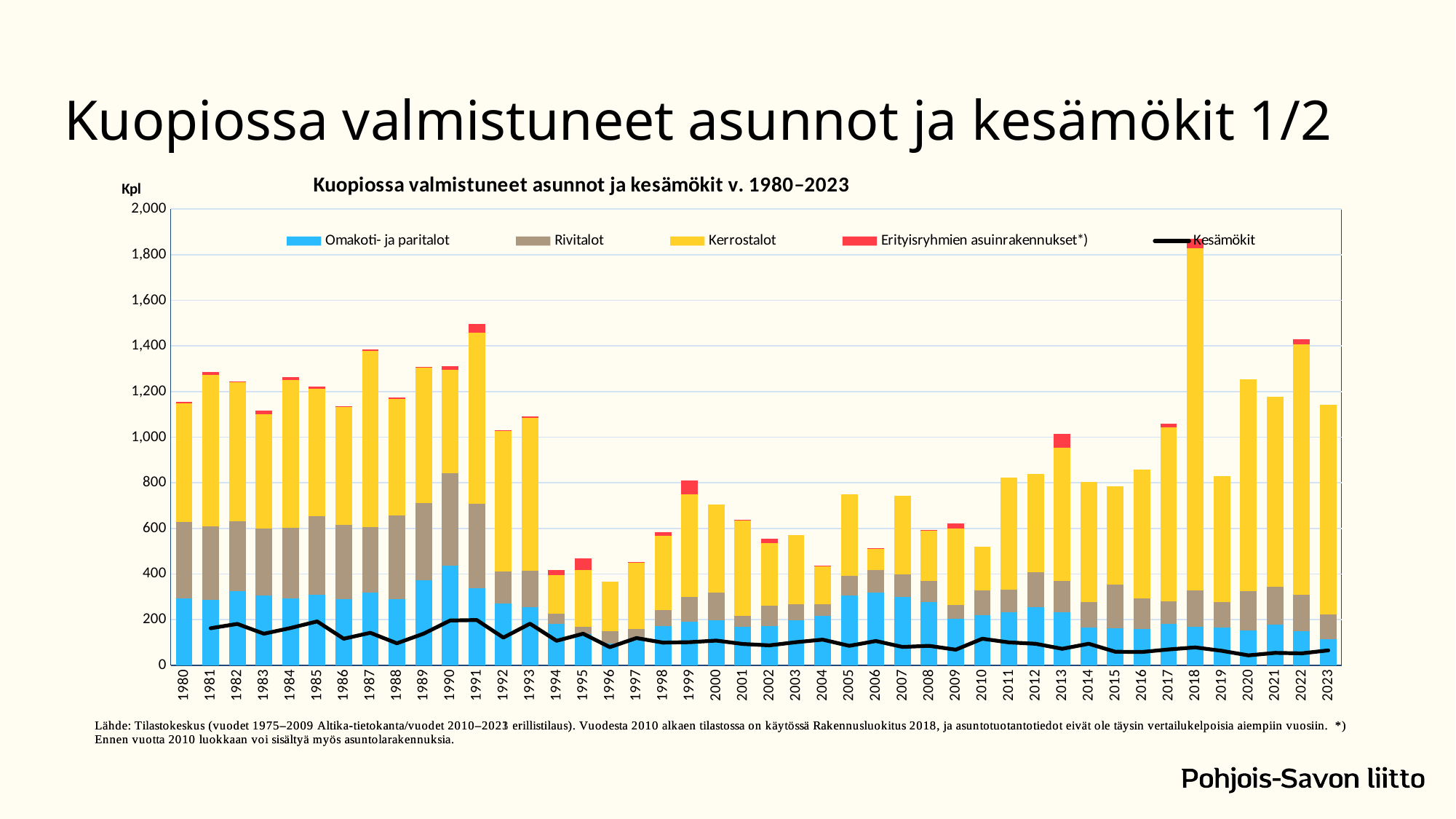
What kind of chart is shown on the slide? Stacked bar chart with a line How many years are shown on the x axis? 44 Is the total bar for 1991 greater or less than 1,400? greater Does the Kesämökit line generally rise or fall from 1980 to 2023? fall Which year has the lowest total bar? 1996 Is the total bar for 2023 greater or less than 1,000? greater What is the title of the chart? Kuopiossa valmistuneet asunnot ja kesämökit v. 1980–2023 Is the total bar for 2018 greater or less than 1,600? greater Which year has the larger total bar, 1987 or 1993? 1987 How many series does the legend list? 5 Which year has the highest total bar? 2018